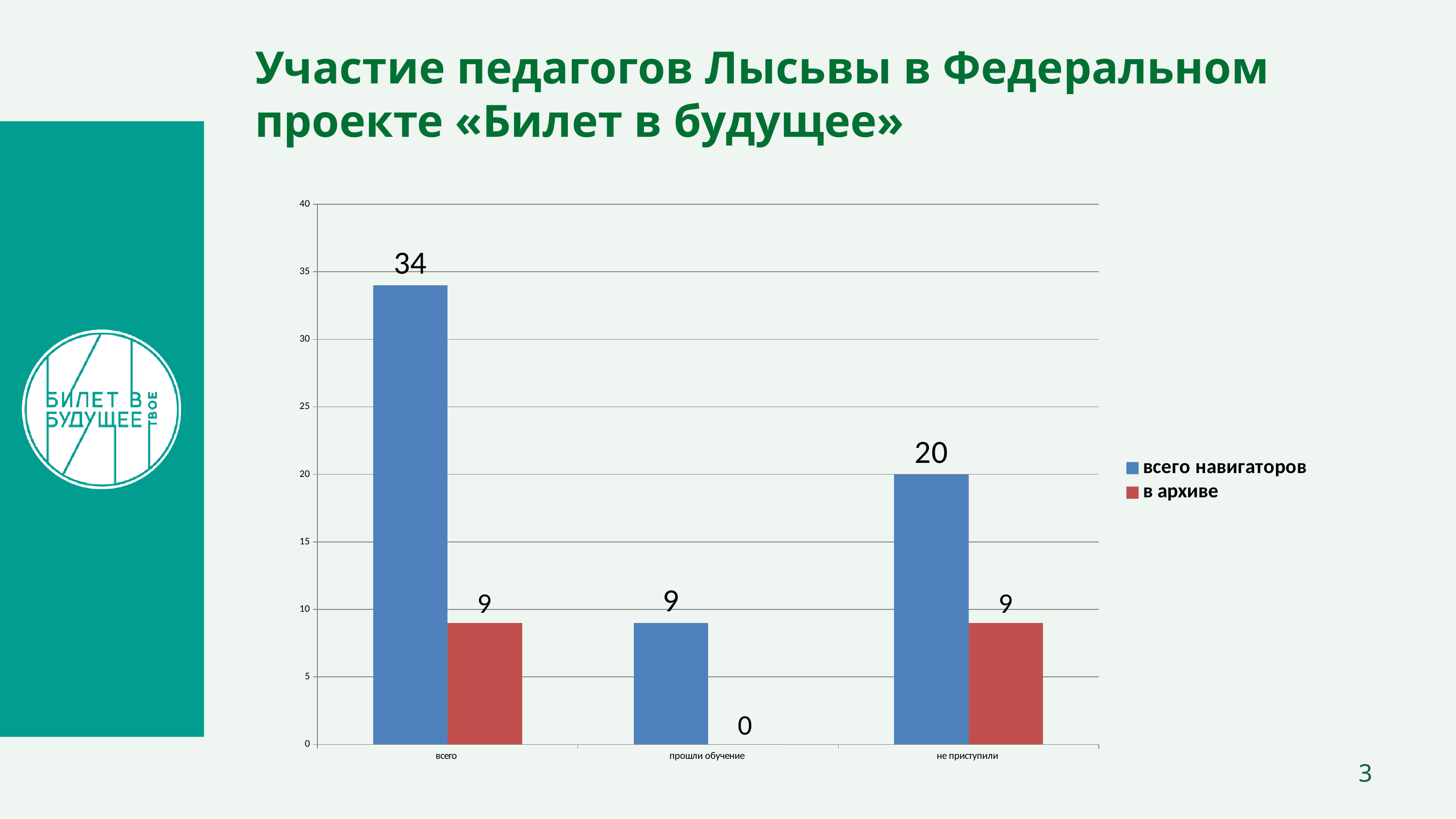
What is the value of 'в архиве' for the category 'не приступили'? 9 Which category has the highest value for 'всего навигаторов'? всего What is the value of 'в архиве' for the category 'прошли обучение'? 0 How many series does the legend list? 2 What is the difference between 'всего навигаторов' for 'всего' and for 'не приступили'? 14 Which category has the lowest value for 'всего навигаторов'? прошли обучение Which colour represents the series 'в архиве' in the legend? red What kind of chart is shown on the slide? bar chart Which is larger: 'всего навигаторов' for 'прошли обучение' or 'всего навигаторов' for 'не приступили'? не приступили What is the value of 'всего навигаторов' for the category 'не приступили'? 20 What is the value of 'всего навигаторов' for the category 'всего'? 34 How many categories are shown on the x axis? 3